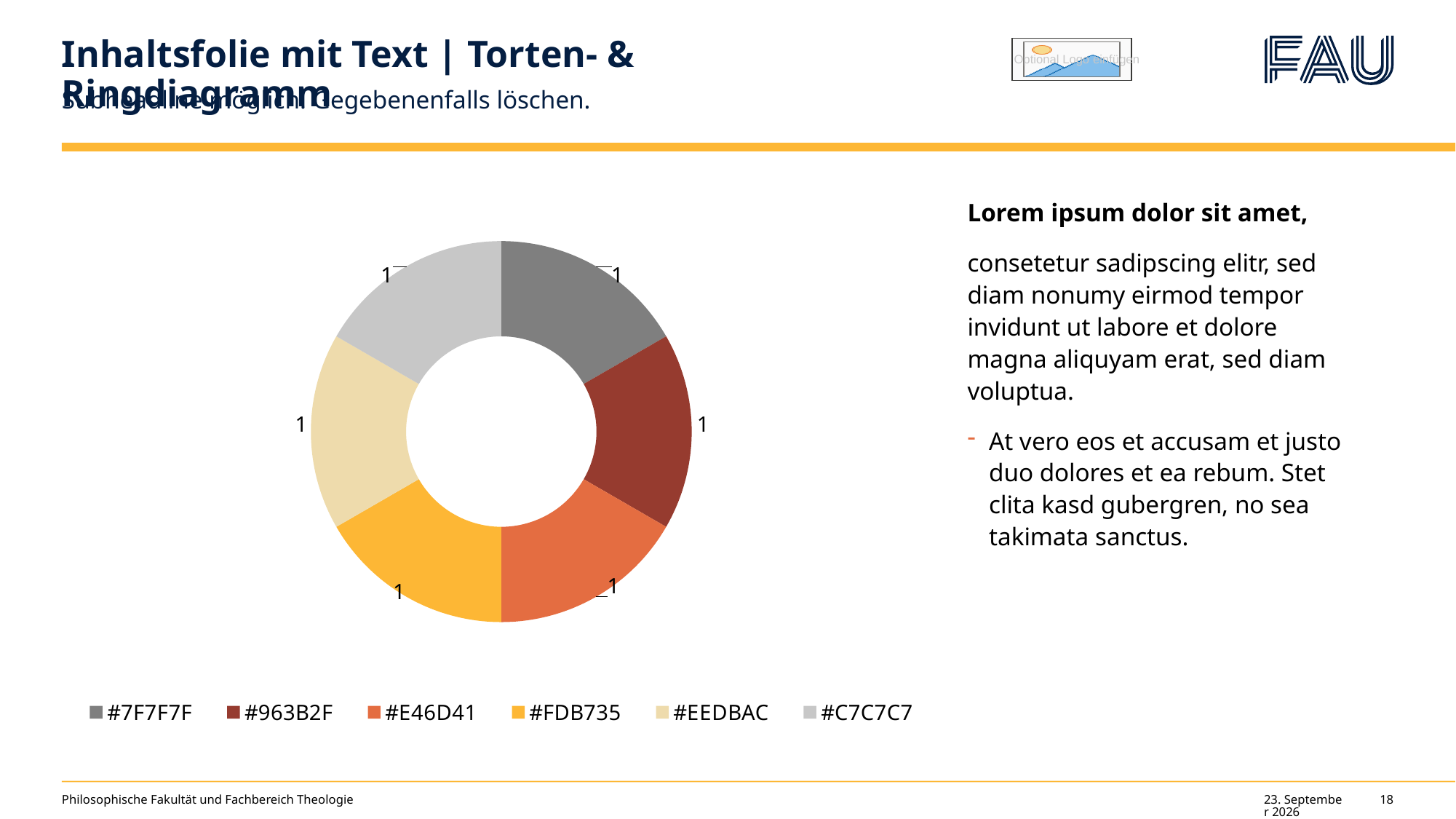
What is the difference between the values of the #E46D41 and #EEDBAC slices? 0 What is the total of all slice values in the doughnut chart? 6 How many entries does the legend of the doughnut chart list? 6 What is the value of the #7F7F7F slice in the doughnut chart? 1 What is the value of the #963B2F slice in the doughnut chart? 1 What is the value of the #C7C7C7 slice in the doughnut chart? 1 What is the value of the #FDB735 slice in the doughnut chart? 1 How many slices does the doughnut chart have? 6 Are all slices of the doughnut chart the same size? Yes Which legend entry is listed first in the doughnut chart's legend? #7F7F7F Which legend entry corresponds to the yellow slice of the doughnut chart? #FDB735 What kind of chart is shown on the slide? Doughnut chart